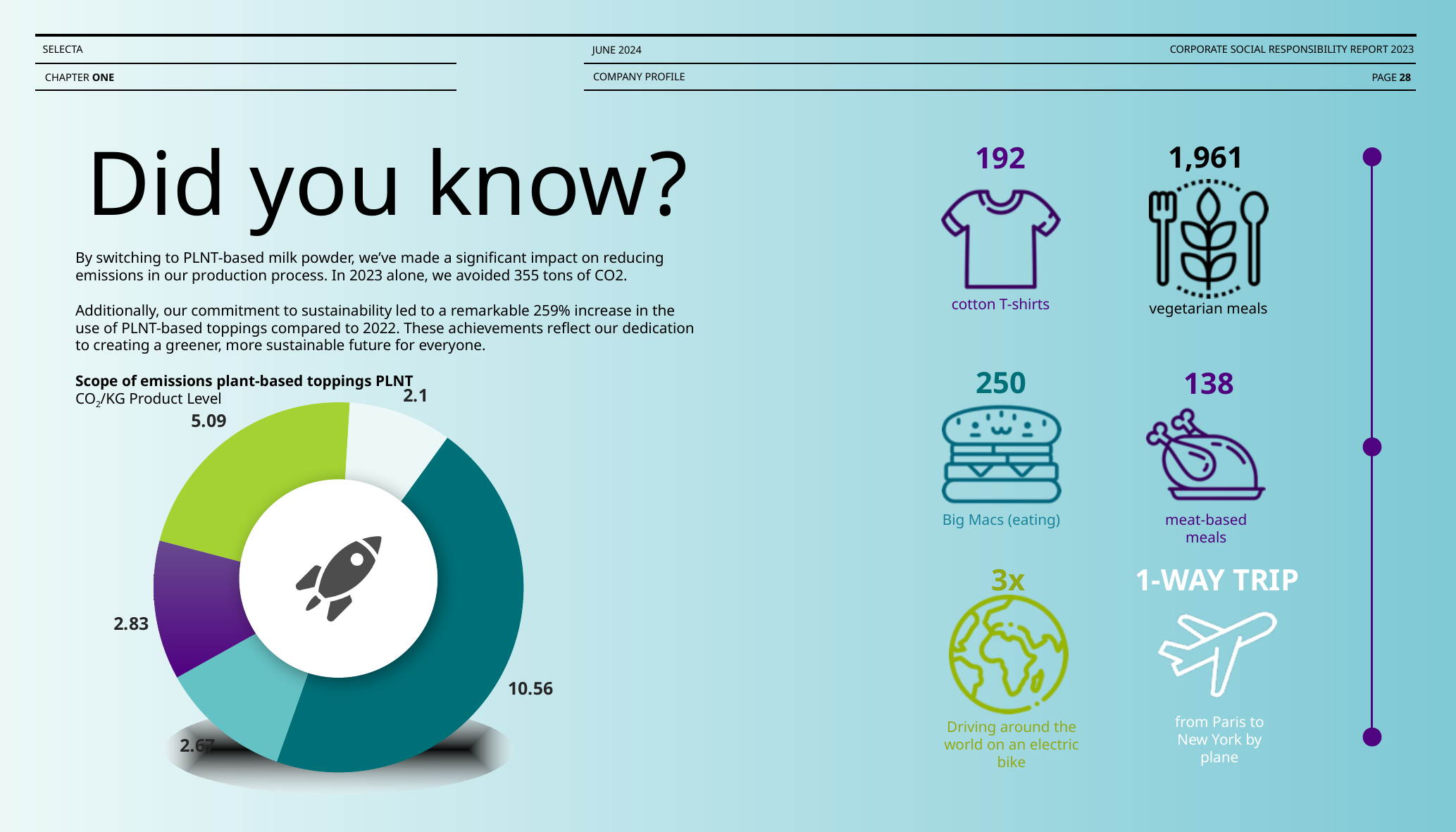
What is the title of the chart on the slide? Scope of emissions plant-based toppings PLNT How many slices does the donut chart have? 5 What is the value of the purple slice in the donut chart? 2.83 What is the value of the smallest slice in the donut chart? 2.1 What is the sum of all five slice values in the donut chart? 23.25 What kind of chart is shown on the slide? Pie (donut) chart What unit is given under the chart title? CO2/KG Product Level What is the value of the largest slice in the donut chart? 10.56 Which slice is larger in the donut chart, the dark teal slice or the green slice? The dark teal slice (10.56) What is the value of the dark teal slice in the donut chart? 10.56 What is the difference between the largest slice (10.56) and the green slice (5.09) in the donut chart? 5.47 What is the value of the green slice in the donut chart? 5.09